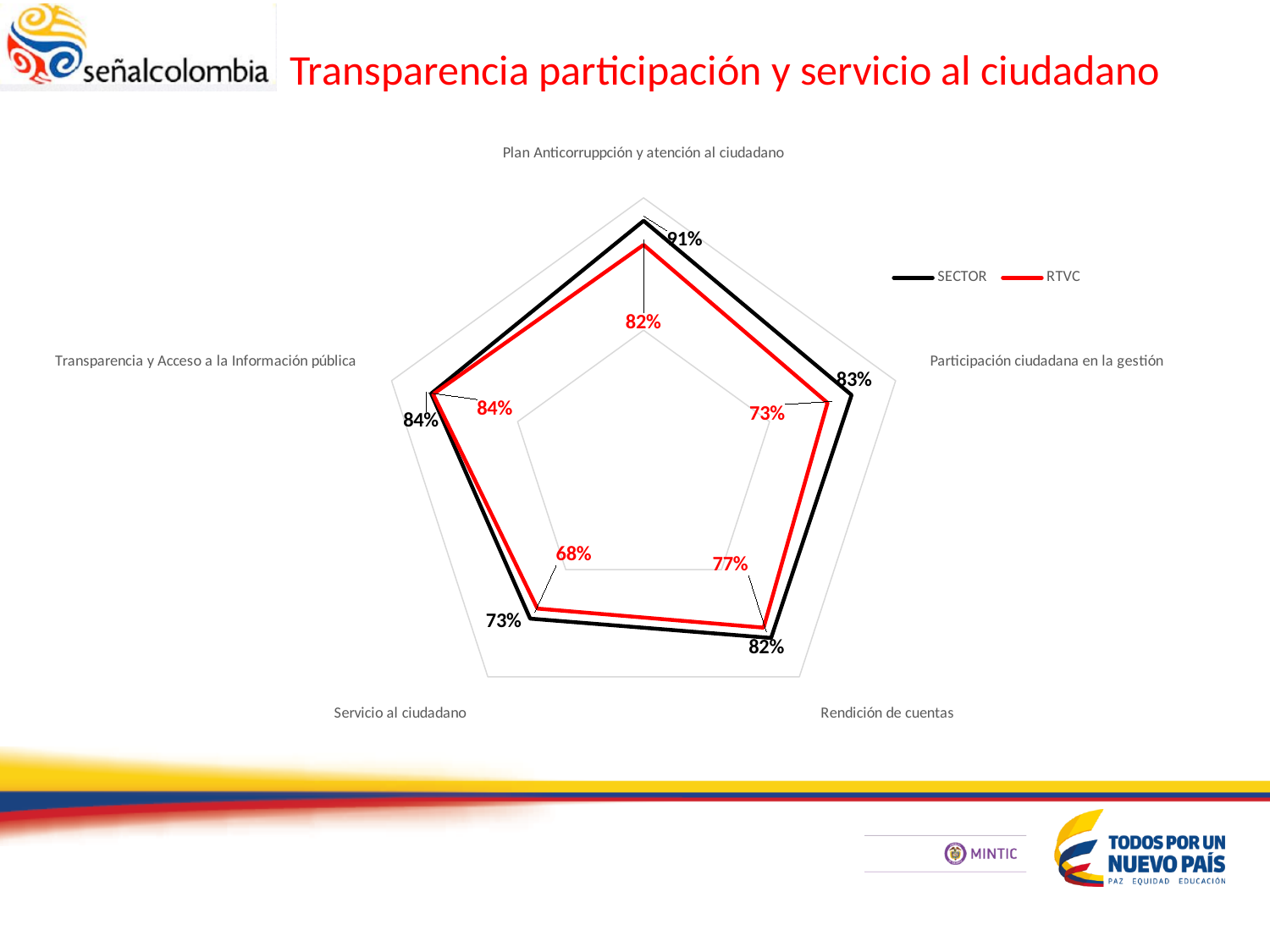
What is the RTVC value for Participación ciudadana en la gestión? 73% What kind of chart is shown on the slide? Radar chart How many categories does the radar chart have? 5 What is the difference between the SECTOR and RTVC values for Participación ciudadana en la gestión? 10% Which series is drawn in red? RTVC Which category has the lowest RTVC value? Servicio al ciudadano Which category has the highest SECTOR value? Plan Anticorruppción y atención al ciudadano What is the SECTOR value for Servicio al ciudadano? 73% What is the RTVC value for Plan Anticorruppción y atención al ciudadano? 82% What is the RTVC value for Rendición de cuentas? 77% What is the SECTOR value for Plan Anticorruppción y atención al ciudadano? 91% How many series does the legend list? 2